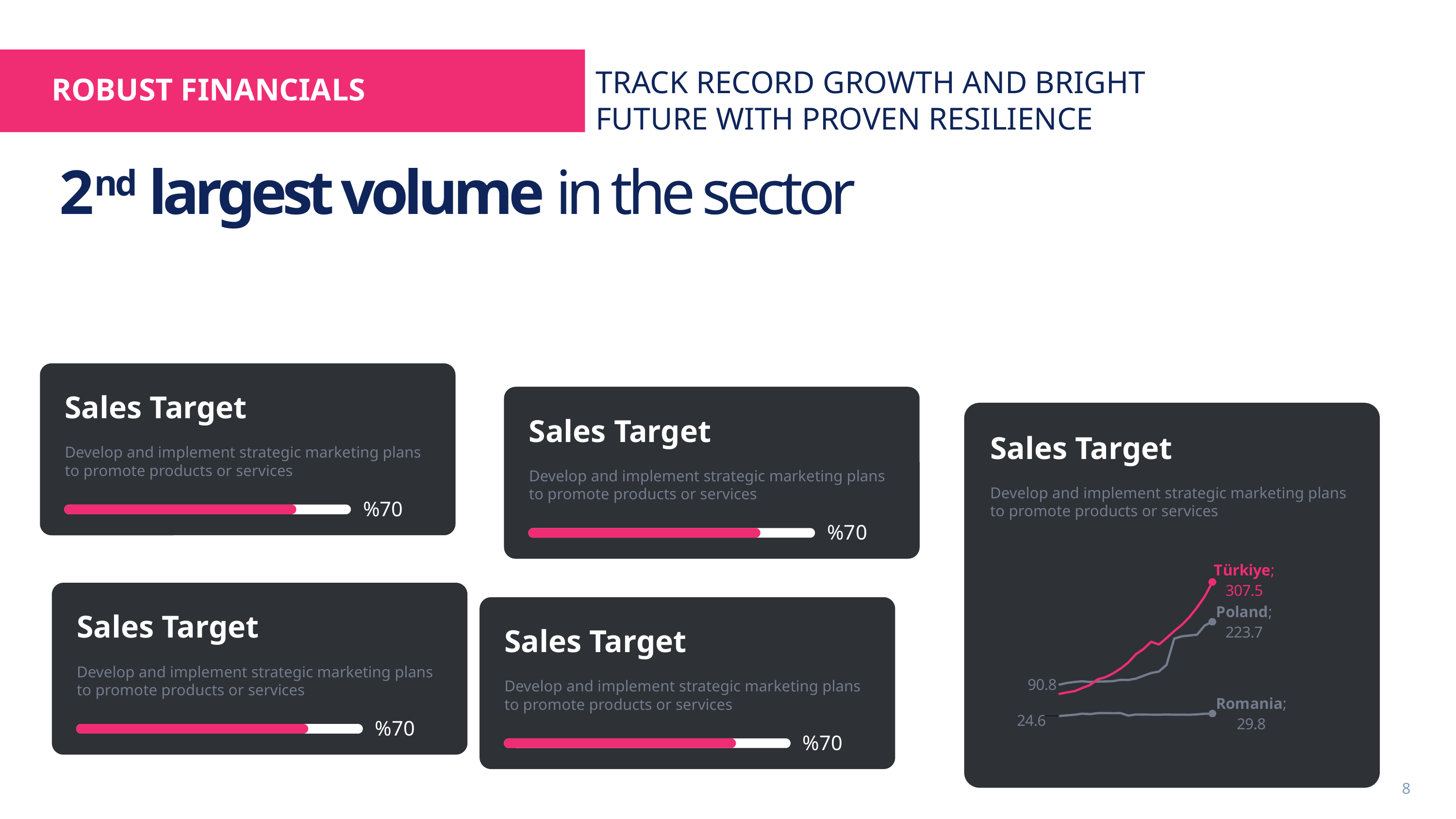
In the line chart, does the Türkiye line rise or fall from left to right? rise In the line chart, which is larger: the final value for Poland or for Romania? Poland What kind of chart is shown in the bottom-right card? line chart In the line chart, which country has the highest final value? Türkiye In the line chart, what is the difference between the final values of Türkiye and Poland? 83.8 In the line chart, what is the difference between the final values of Poland and Romania? 193.9 In the line chart, which country has the lowest final value? Romania In the line chart, what is the starting value labelled for Romania? 24.6 In the line chart, what is the final value labelled for Poland? 223.7 How many country lines are plotted in the line chart? 3 In the line chart, what is the final value labelled for Türkiye? 307.5 In the line chart, what is the final value labelled for Romania? 29.8